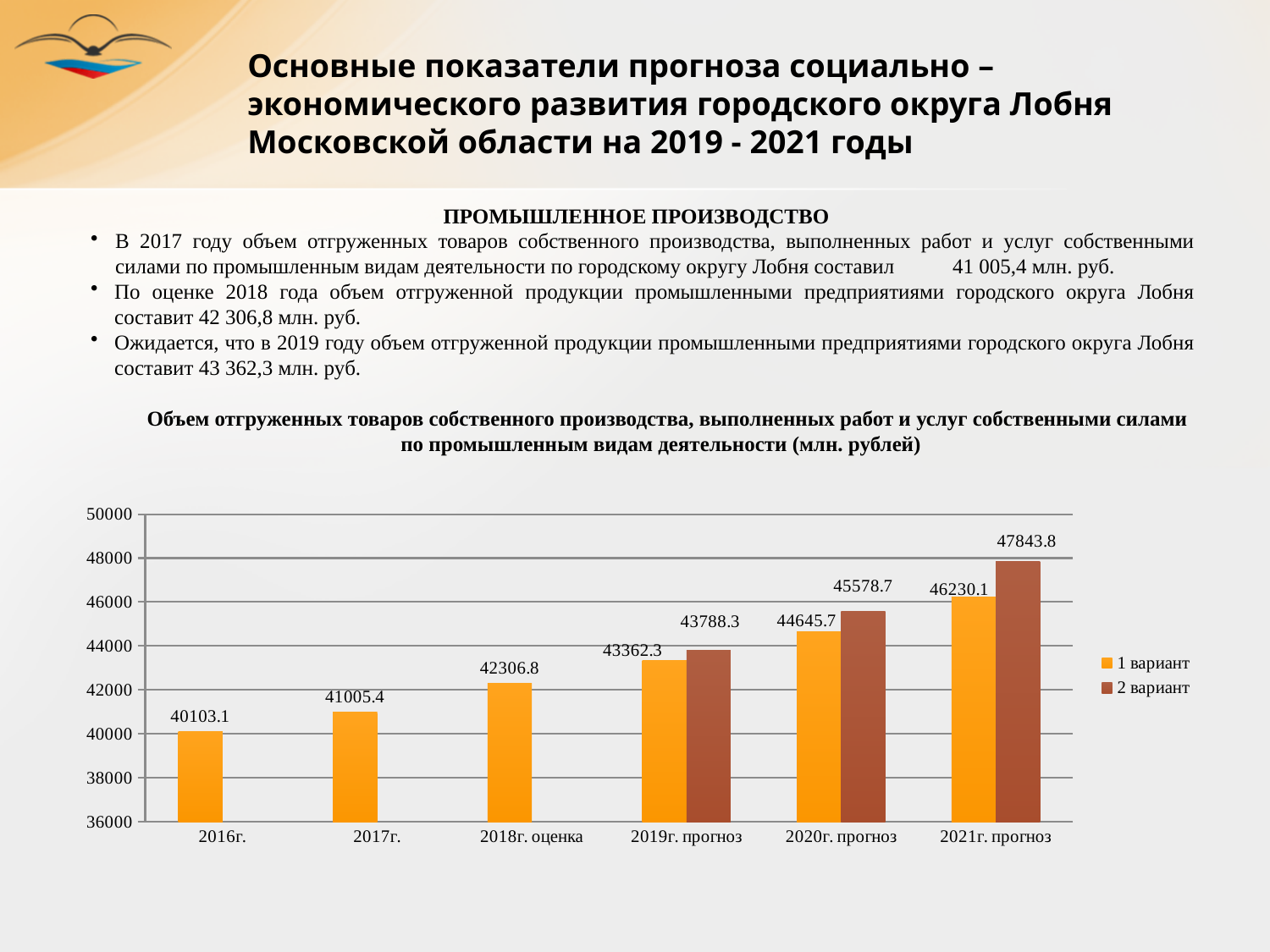
Which category has the highest value for 1 вариант? 2021г. прогноз Which is larger in 2020г. прогноз: 1 вариант or 2 вариант? 2 вариант What kind of chart is shown on the slide? bar chart What is the value for 1 вариант in 2020г. прогноз? 44645.7 What is the difference between 2 вариант and 1 вариант in 2019г. прогноз? 426 Is the value for 1 вариант in 2018г. оценка greater or less than 42000? greater What is the value for 2 вариант in 2021г. прогноз? 47843.8 What is the value for 1 вариант in 2017г.? 41005.4 Which category has the lowest value for 1 вариант? 2016г. How many series does the legend list? 2 How many categories are shown on the x axis? 6 Do the values for 1 вариант rise or fall from 2016г. to 2021г. прогноз? rise